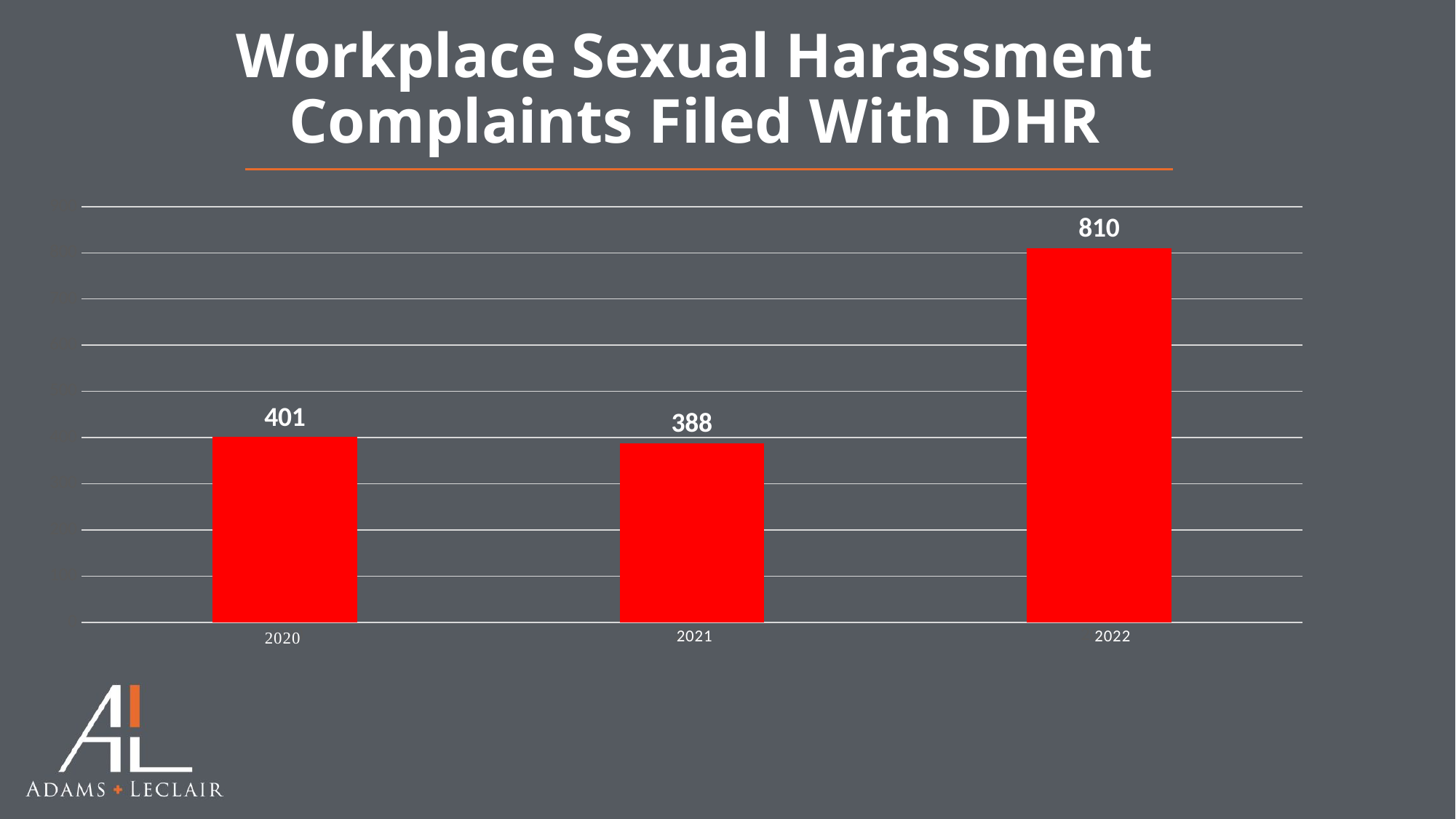
What is the value for 2021? 388 What is the difference between the values for 2020 and 2021? 13 What is the value for 2022? 810 What is the value for 2020? 401 What colour are the bars in the chart? red Which year has the highest number of complaints? 2022 What kind of chart is shown on the slide? bar chart What is the title of the chart? Workplace Sexual Harassment Complaints Filed With DHR Which is larger, the value for 2020 or the value for 2022? 2022 How many years are shown on the chart? 3 Which year has the lowest number of complaints? 2021 What is the difference between the values for 2022 and 2021? 422